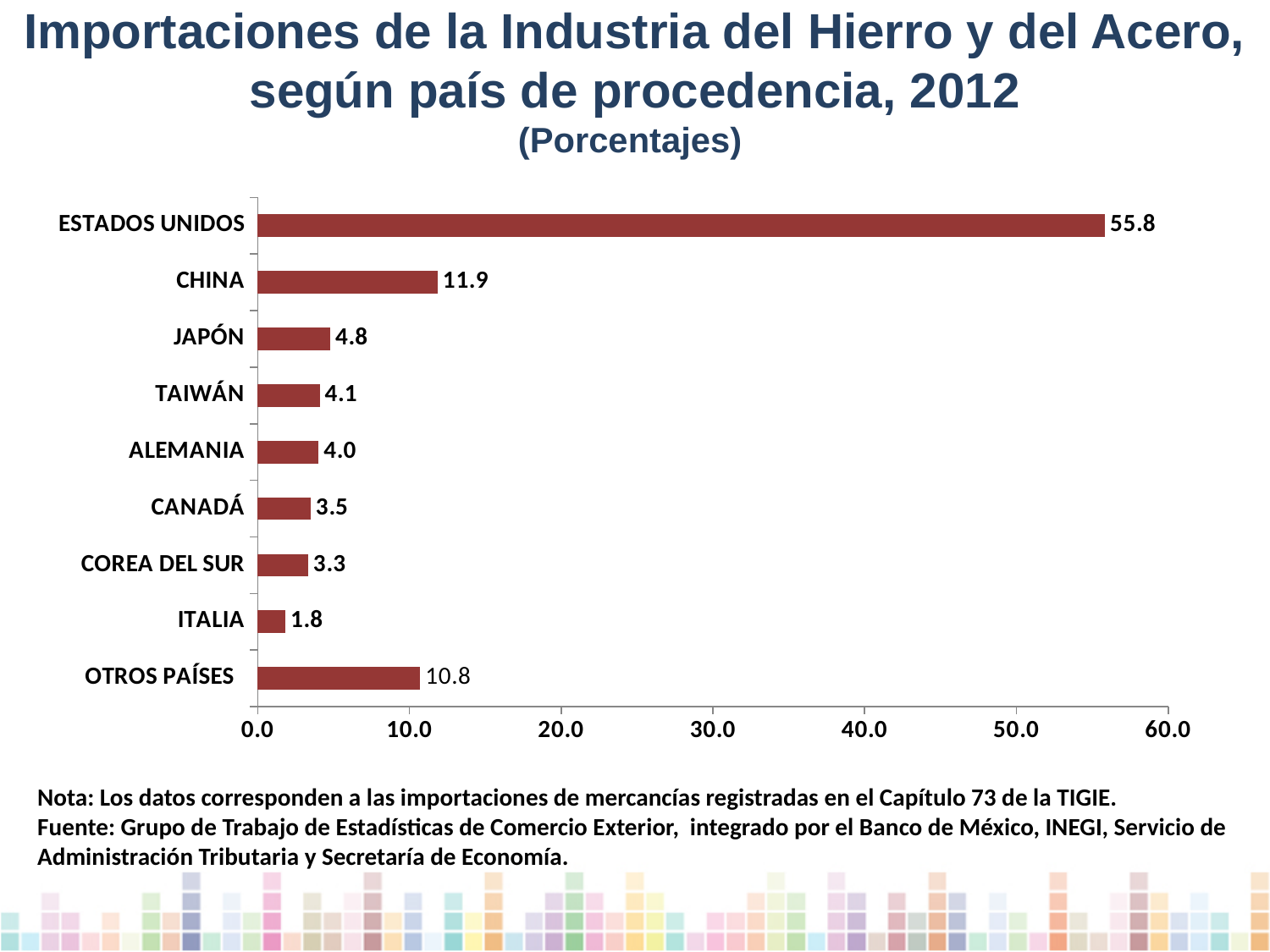
Is the value for ESTADOS UNIDOS greater or less than 50.0? greater What is the value for COREA DEL SUR? 3.3 What is the value for OTROS PAÍSES? 10.8 How many categories are shown in the chart? 9 What is the value for CHINA? 11.9 What kind of chart is shown on the slide? bar chart What is the difference between the values for JAPÓN and ITALIA? 3.0 Which category has the lowest value? ITALIA Which category has the highest value? ESTADOS UNIDOS What is the difference between the values for ESTADOS UNIDOS and CHINA? 43.9 What is the value for ESTADOS UNIDOS? 55.8 Which is larger, the value for CHINA or the value for OTROS PAÍSES? CHINA